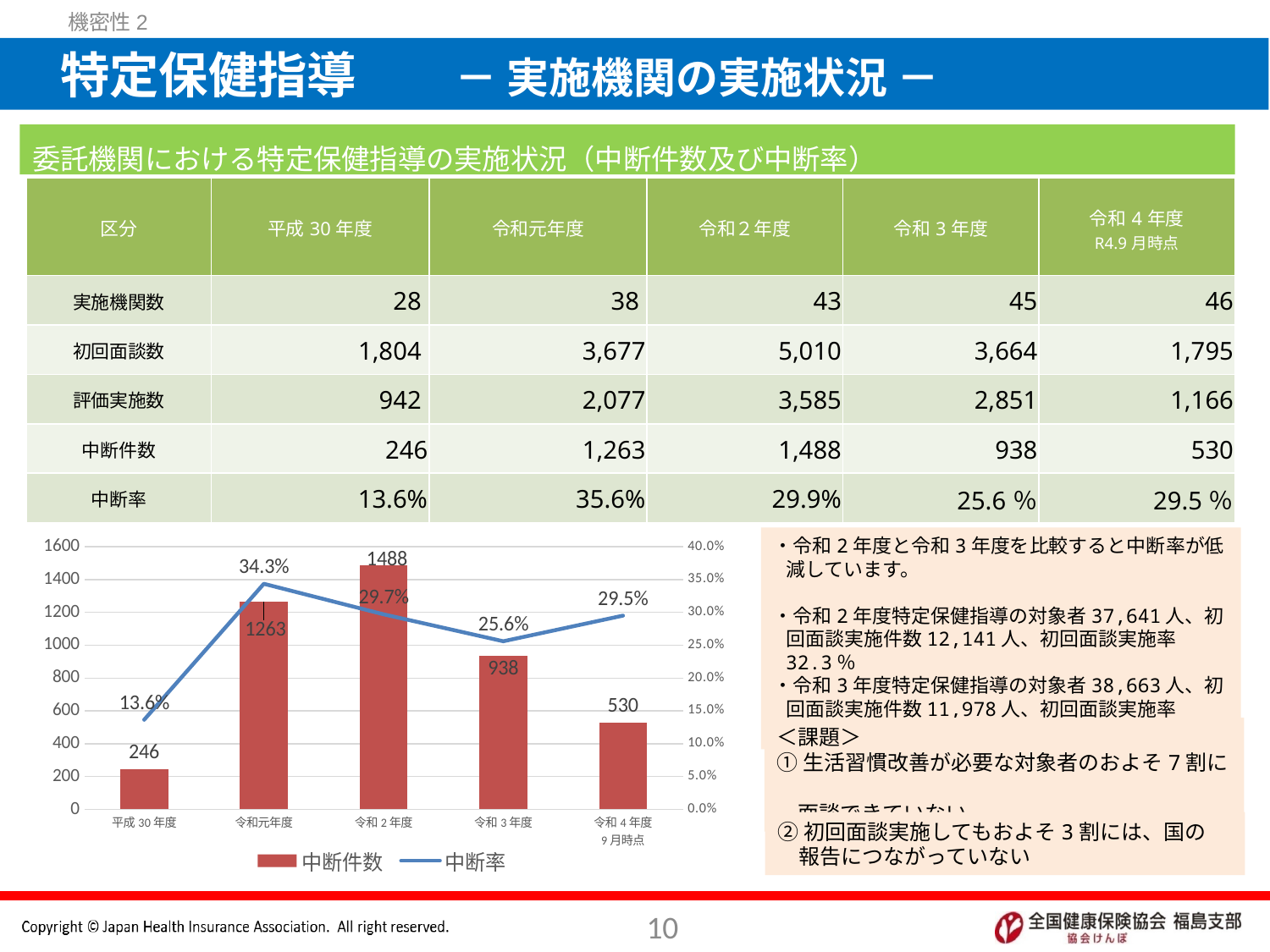
What is the 中断件数 value for 平成30年度 in the chart? 246 What is the 中断件数 value for 令和2年度 in the chart? 1488 What is the difference in 中断件数 between 令和2年度 and 令和3年度 in the chart? 550 What kind of chart is shown on the slide? Combined bar and line chart What 中断率 value does the chart show for 令和元年度? 34.3% Does the 中断件数 rise or fall from 令和2年度 to 令和4年度 9月時点 in the chart? Fall How many series does the chart legend list? 2 What 中断率 does the chart show for 令和4年度 9月時点? 29.5% Which year has the lowest 中断率 in the chart? 平成30年度 How many year categories are shown on the x axis of the chart? 5 Which is larger in the chart: the 中断件数 for 令和元年度 or for 令和3年度? 令和元年度 Which year has the highest 中断件数 in the chart? 令和2年度